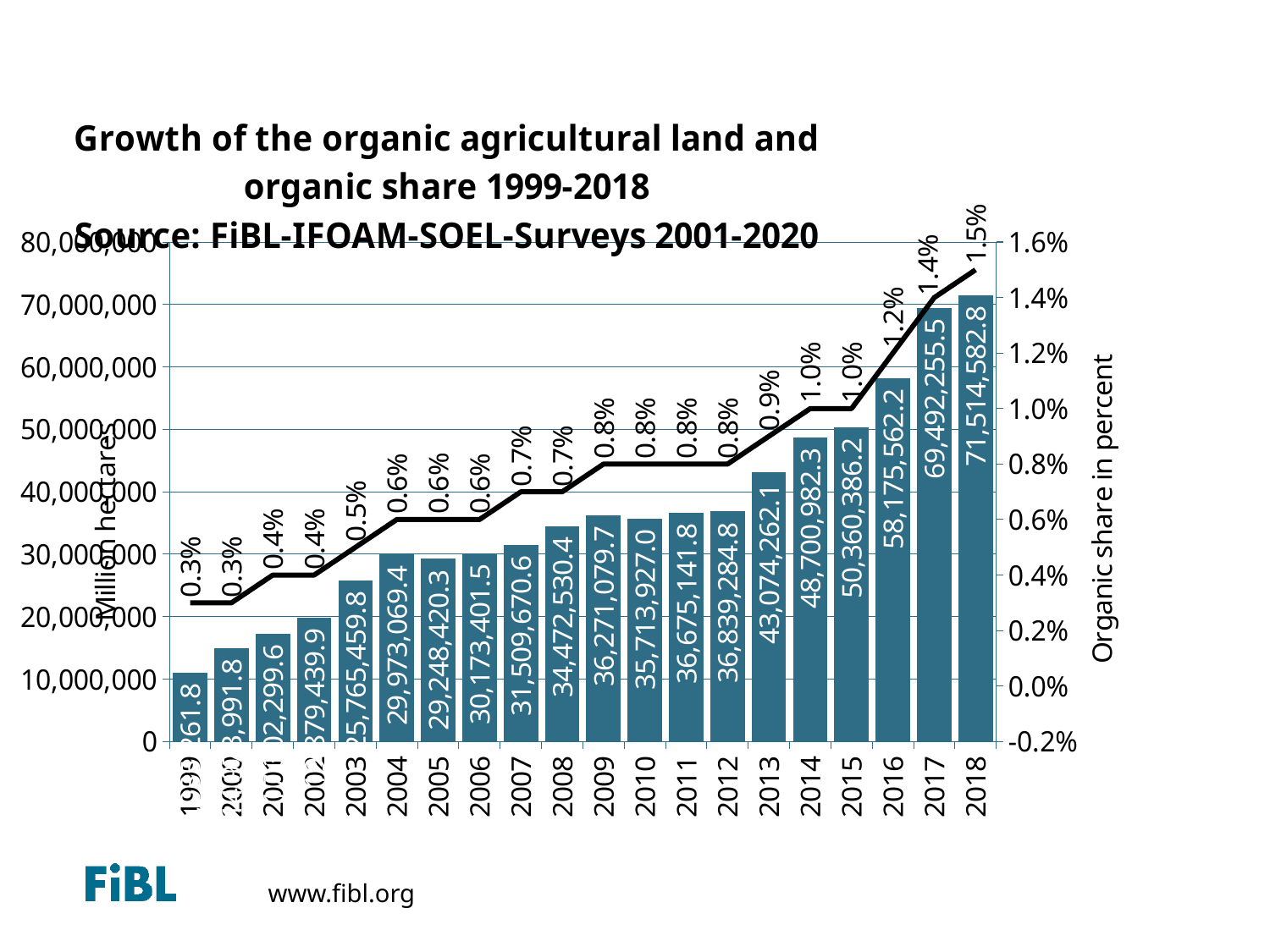
What is the organic agricultural land value shown for 2018? 71,514,582.8 What is the difference between the organic agricultural land values for 2018 and 2017? 2,022,327.3 Which year has the lowest organic share in percent on the line? 1999 and 2000 (tied at 0.3%) Does the organic share in percent rise or fall from 1999 to 2018? Rise What organic share in percent is shown for 2017? 1.4% How many years are shown on the x axis of the chart? 20 Which year has the larger organic agricultural land value, 2009 or 2010? 2009 Which year has the highest organic agricultural land value? 2018 Is the organic agricultural land value for 2014 greater or less than 40,000,000? greater What organic share in percent is shown for 2003? 0.5% What is the organic agricultural land value shown for 2013? 43,074,262.1 What kind of chart is shown on the slide? Combined bar and line chart